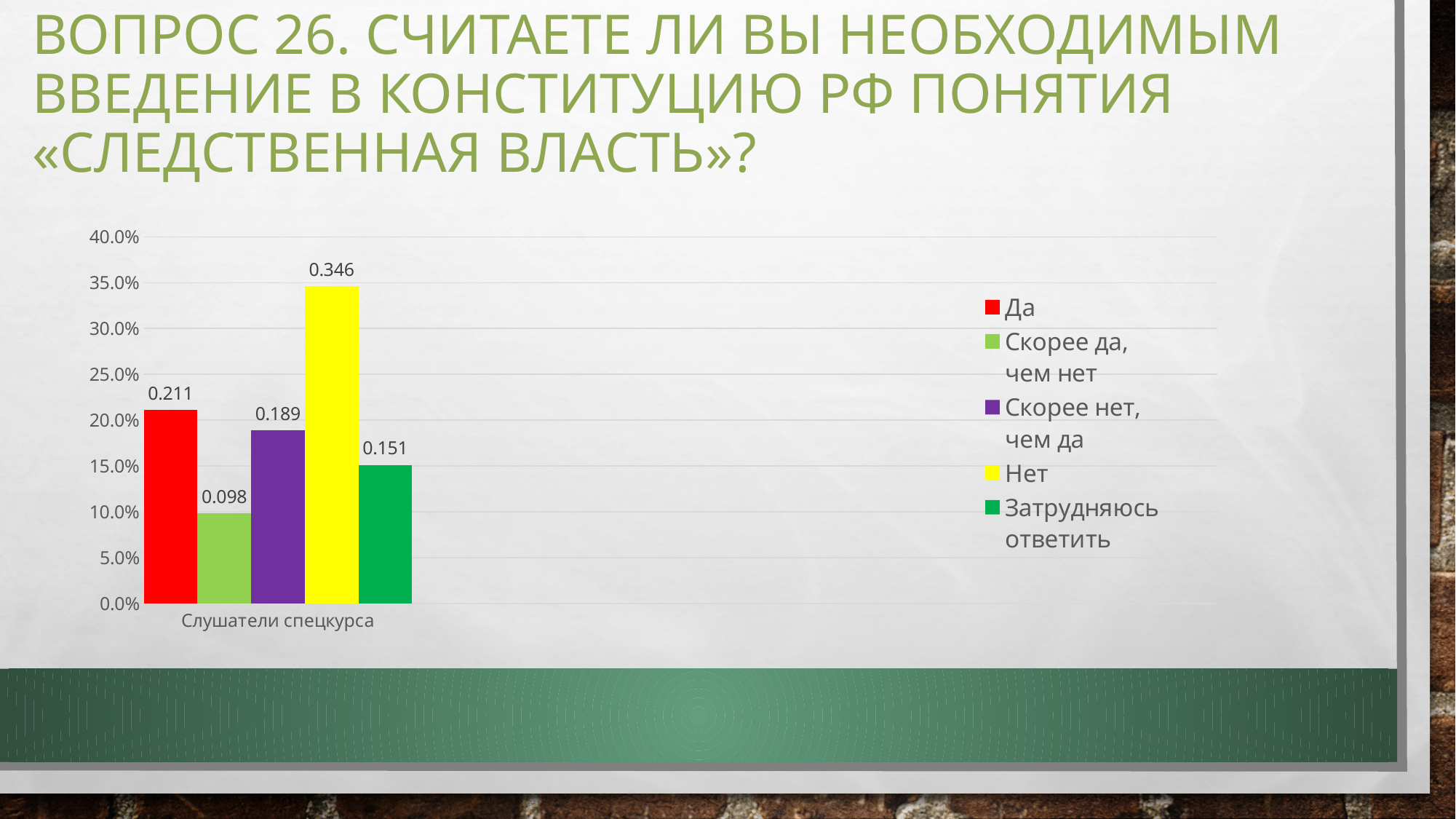
What colour is the bar for "Нет"? yellow Which series has the lowest value? Скорее да, чем нет What is the difference between the values for "Нет" and "Да"? 0.135 How many series does the legend list? 5 What kind of chart is shown on the slide? bar chart Which series has the highest value? Нет What is the value for "Да"? 0.211 Which is larger, the value for "Скорее нет, чем да" or the value for "Затрудняюсь ответить"? Скорее нет, чем да Is the value for "Да" greater or less than 20.0%? greater What is the value for "Нет"? 0.346 What is the value for "Затрудняюсь ответить"? 0.151 What is the value for "Скорее да, чем нет"? 0.098